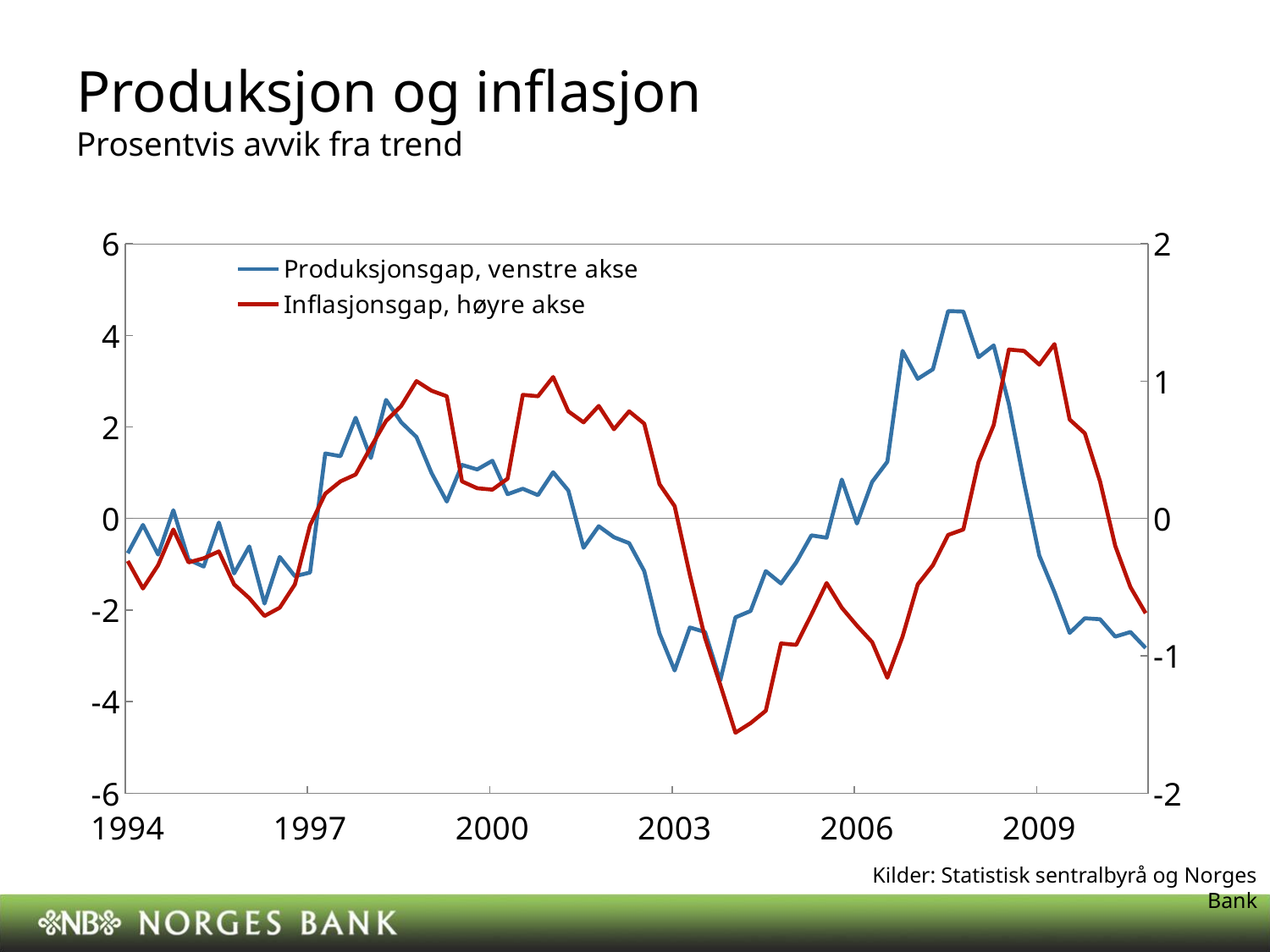
What kind of chart is shown on the slide? Line chart Does Produksjonsgap rise or fall between 2008 and the end of the series? fall Which peak of Produksjonsgap is higher: the one around 1998 or the one around 2008? 2008 Is the peak value of Inflasjonsgap around 2009 greater or less than 1 on the right axis? greater How many year labels are shown on the x axis? 6 Is the lowest value of Produksjonsgap around 2003 greater or less than -2 on the left axis? less Which trough of Inflasjonsgap is lower: the one around 1996 or the one around 2004? 2004 Which series is plotted against the right-hand axis according to the legend? Inflasjonsgap What is the subtitle of the chart? Prosentvis avvik fra trend How many series does the legend list? 2 Is the peak value of Produksjonsgap around 2008 greater or less than 4 on the left axis? greater